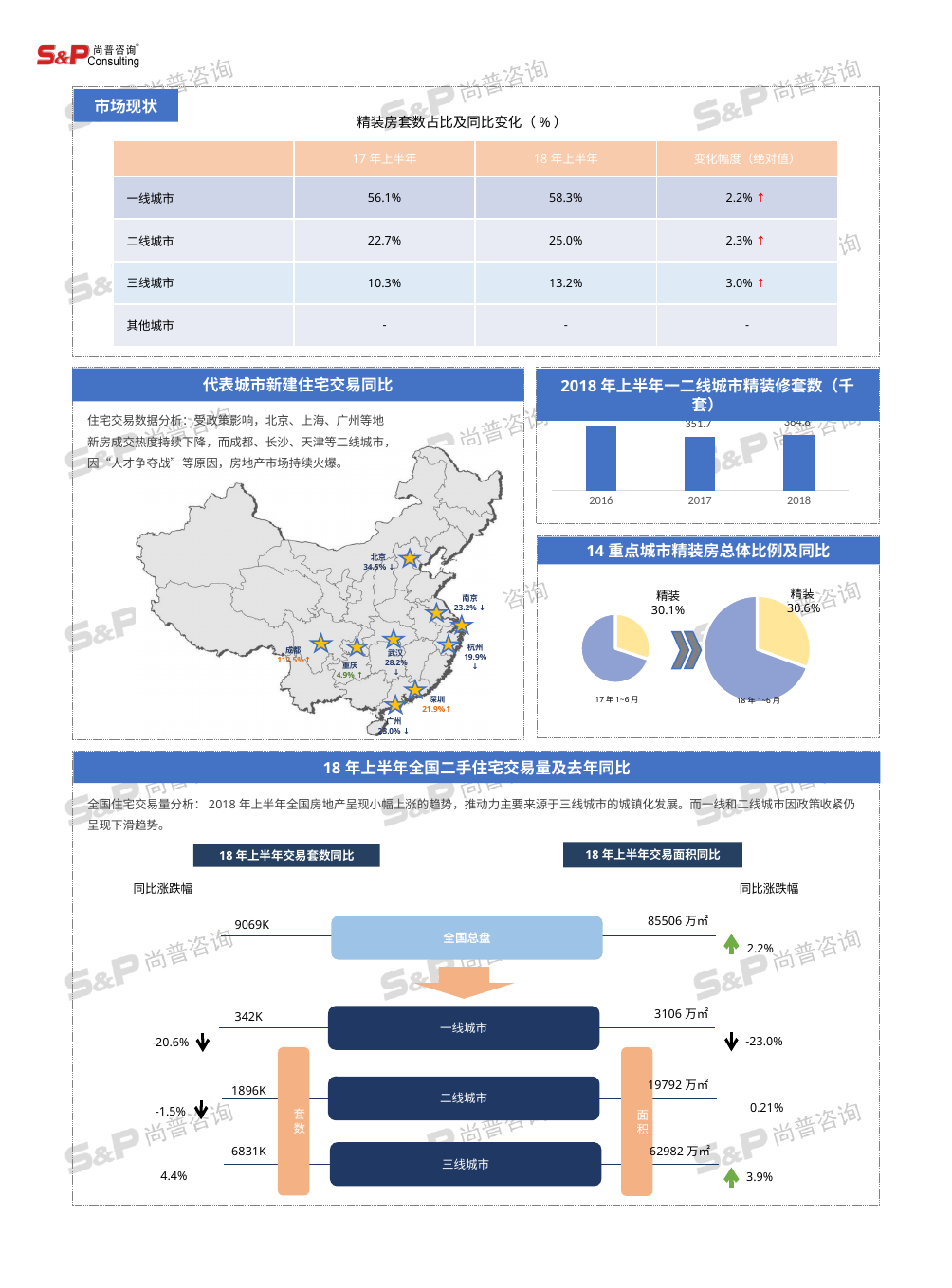
In the "2018年上半年一二线城市精装修套数（千套）" chart, what is the value for 2017? 351.7 How many years are shown in the "2018年上半年一二线城市精装修套数（千套）" bar chart? 3 In the "代表城市新建住宅交易同比" map chart, what is the value shown for 深圳? 21.9% In the "代表城市新建住宅交易同比" map chart, what is the value shown for 成都? 119.5% In the "14重点城市精装房总体比例及同比" chart, did the 精装 share rise or fall from 17年1~6月 to 18年1~6月? rise In the "代表城市新建住宅交易同比" map chart, what is the value shown for 南京? 23.2% What kind of chart is the "2018年上半年一二线城市精装修套数（千套）" chart? bar chart In the "14重点城市精装房总体比例及同比" chart, what share does 精装 have in the 18年1~6月 pie? 30.6% What kind of chart is used in the "14重点城市精装房总体比例及同比" section? pie chart In the "2018年上半年一二线城市精装修套数（千套）" chart, is the value for 2018 larger or smaller than the value for 2017? larger In the "14重点城市精装房总体比例及同比" chart, what share does 精装 have in the 17年1~6月 pie? 30.1% In the "代表城市新建住宅交易同比" map chart, what is the value shown for 北京? 34.5%